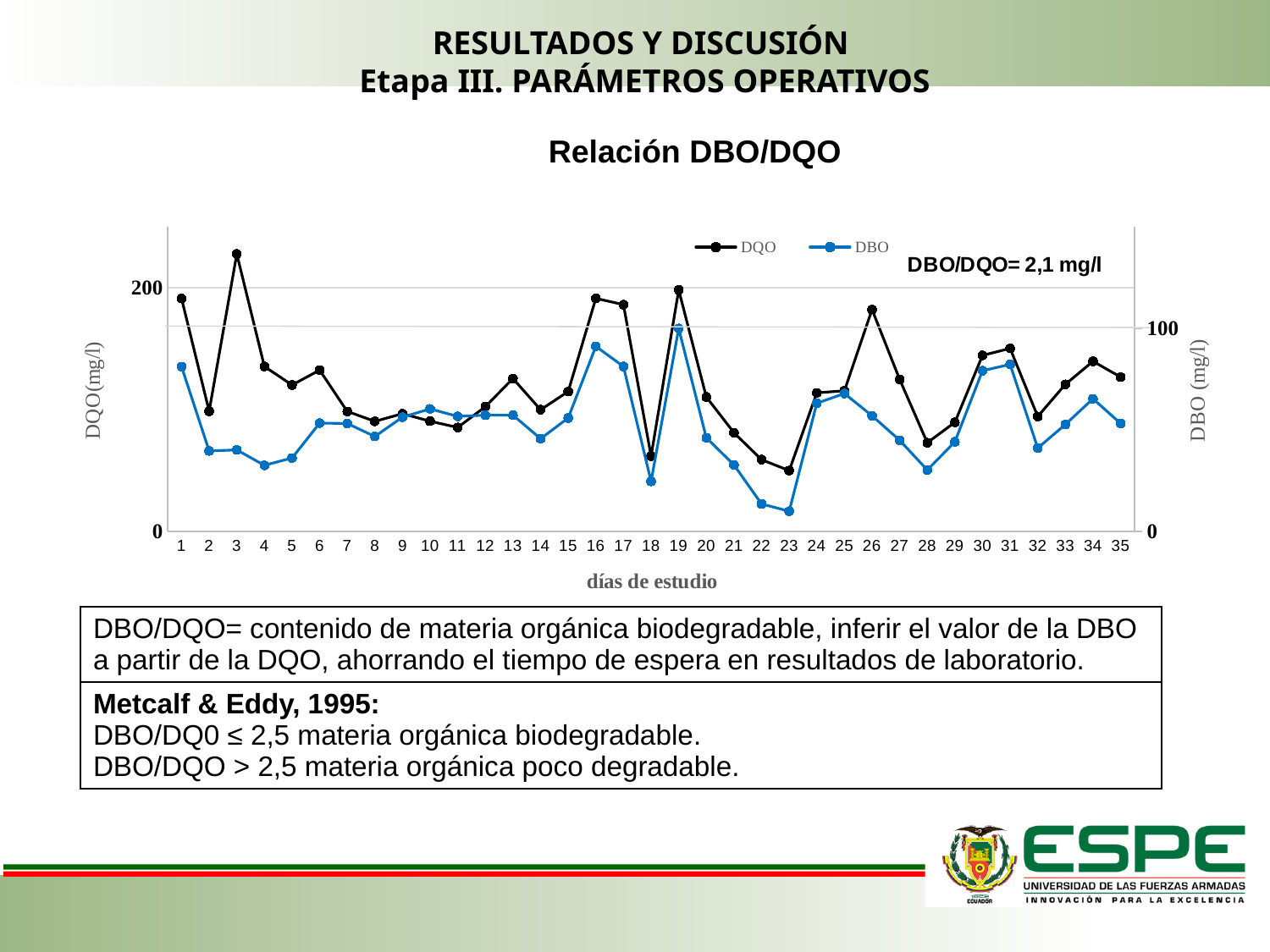
What is the title of the chart? Relación DBO/DQO Is the DBO value on day 19 greater or less than 50? greater What DBO/DQO ratio is annotated on the chart? DBO/DQO= 2,1 mg/l Does the DQO series rise or fall from day 19 to day 23? Fall Which is larger, the DQO value on day 3 or on day 26? Day 3 On which day does the DQO series reach its highest value? 3 On which day does the DBO series reach its highest value? 19 Is the DQO value on day 3 greater or less than 200? greater What kind of chart is shown on the slide? Line chart Is the DQO value on day 23 greater or less than 100? less How many series does the legend list? 2 How many days of study are plotted along the x axis? 35